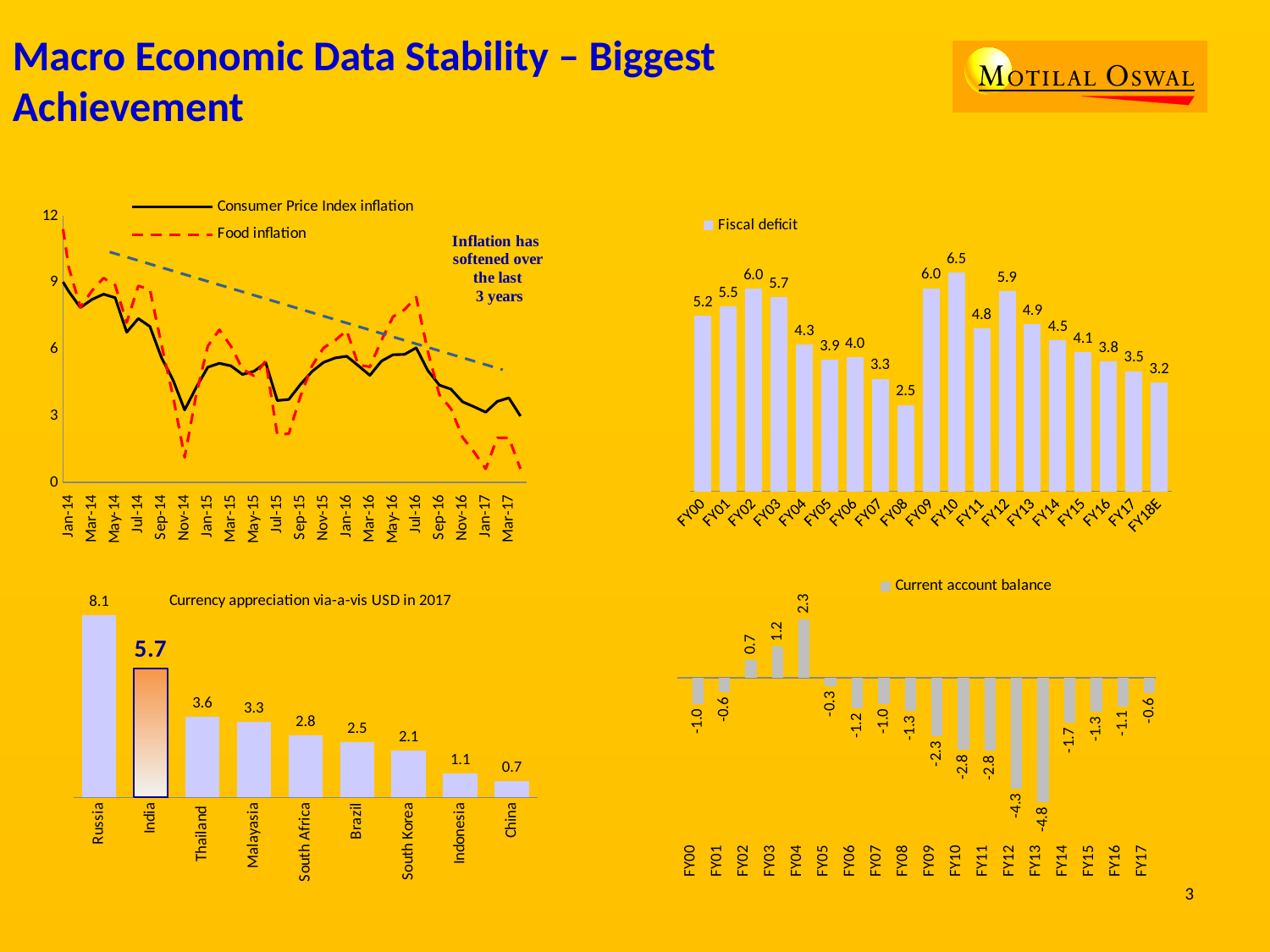
In the Current account balance chart, which fiscal year has the highest current account balance? FY04 In the Currency appreciation vis-a-vis USD in 2017 chart, which is larger, the value for Malaysia or the value for Brazil? Malaysia In the top-left inflation chart, is the Consumer Price Index inflation value for Jan-14 greater or less than 6? greater In the Fiscal deficit chart, which fiscal year has the lowest fiscal deficit? FY08 In the Current account balance chart, what is the value for FY13? -4.8 In the Fiscal deficit chart, what is the difference between the FY12 and FY18E values? 2.7 In the Currency appreciation vis-a-vis USD in 2017 chart, what is the value for India? 5.7 In the Currency appreciation vis-a-vis USD in 2017 chart, which country has the highest value? Russia In the Fiscal deficit chart, how many fiscal years are plotted? 19 In the Fiscal deficit chart, what is the value for FY10? 6.5 In the Currency appreciation vis-a-vis USD in 2017 chart, how many countries are shown? 9 In the top-left inflation chart, how many series does the legend list? 2